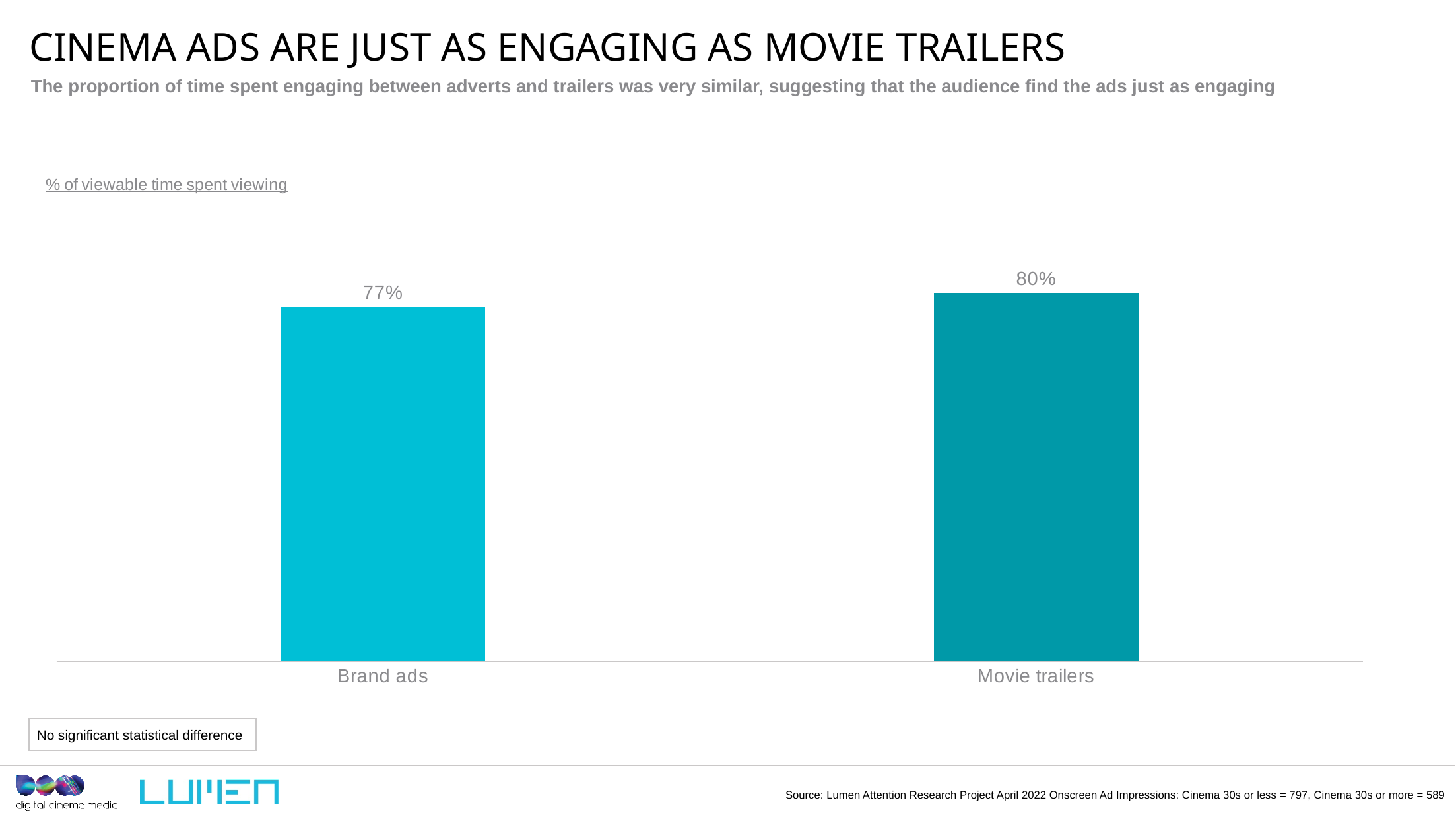
What does the chart measure, according to the label above it? % of viewable time spent viewing What is the value for Movie trailers? 80% Which category has the lowest value? Brand ads Which category has the highest value? Movie trailers What is the difference between the values for Movie trailers and Brand ads? 3% What kind of chart is shown on the slide? Bar chart How many categories are shown in the chart? 2 Which is larger, the value for Brand ads or the value for Movie trailers? Movie trailers What does the note box below the chart say? No significant statistical difference What is the value for Brand ads? 77%